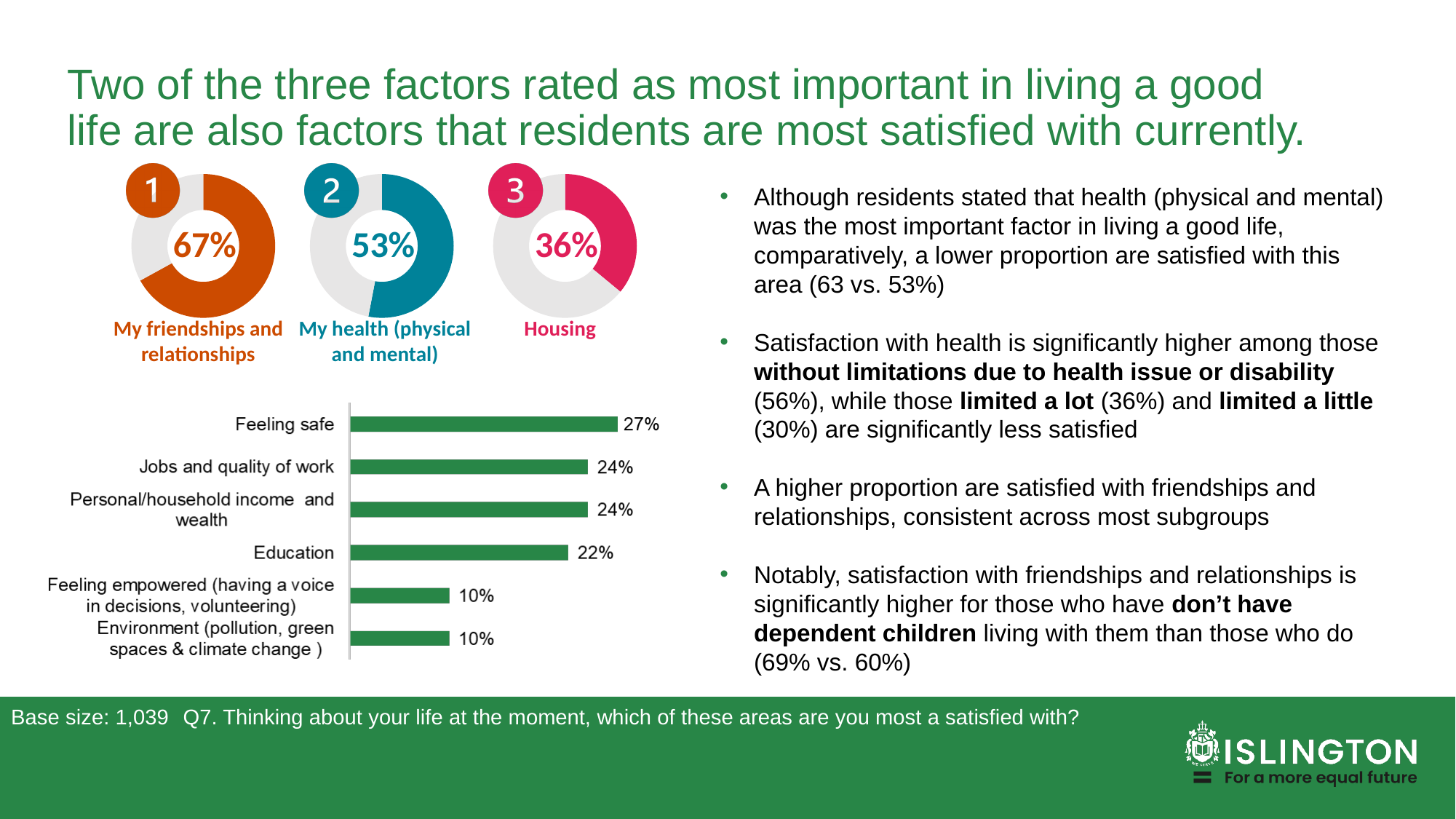
In the donut charts at the top left, which factor has the lowest percentage? Housing How many categories does the bar chart show? 6 In the bar chart, what is the value for Environment (pollution, green spaces & climate change)? 10% In the bar chart, what is the value for Feeling safe? 27% In the bar chart, which category has the highest value? Feeling safe In the donut charts at the top left, what is the difference between My friendships and relationships and My health (physical and mental)? 14% In the bar chart, what is the difference between Feeling safe and Education? 5% In the donut charts at the top left, what percentage is shown for My friendships and relationships? 67% What kind of chart is the chart at the bottom left of the slide? bar chart In the bar chart, which is larger: Jobs and quality of work or Feeling empowered (having a voice in decisions, volunteering)? Jobs and quality of work In the donut charts at the top left, what percentage is shown for Housing? 36% In the bar chart, what is the value for Education? 22%